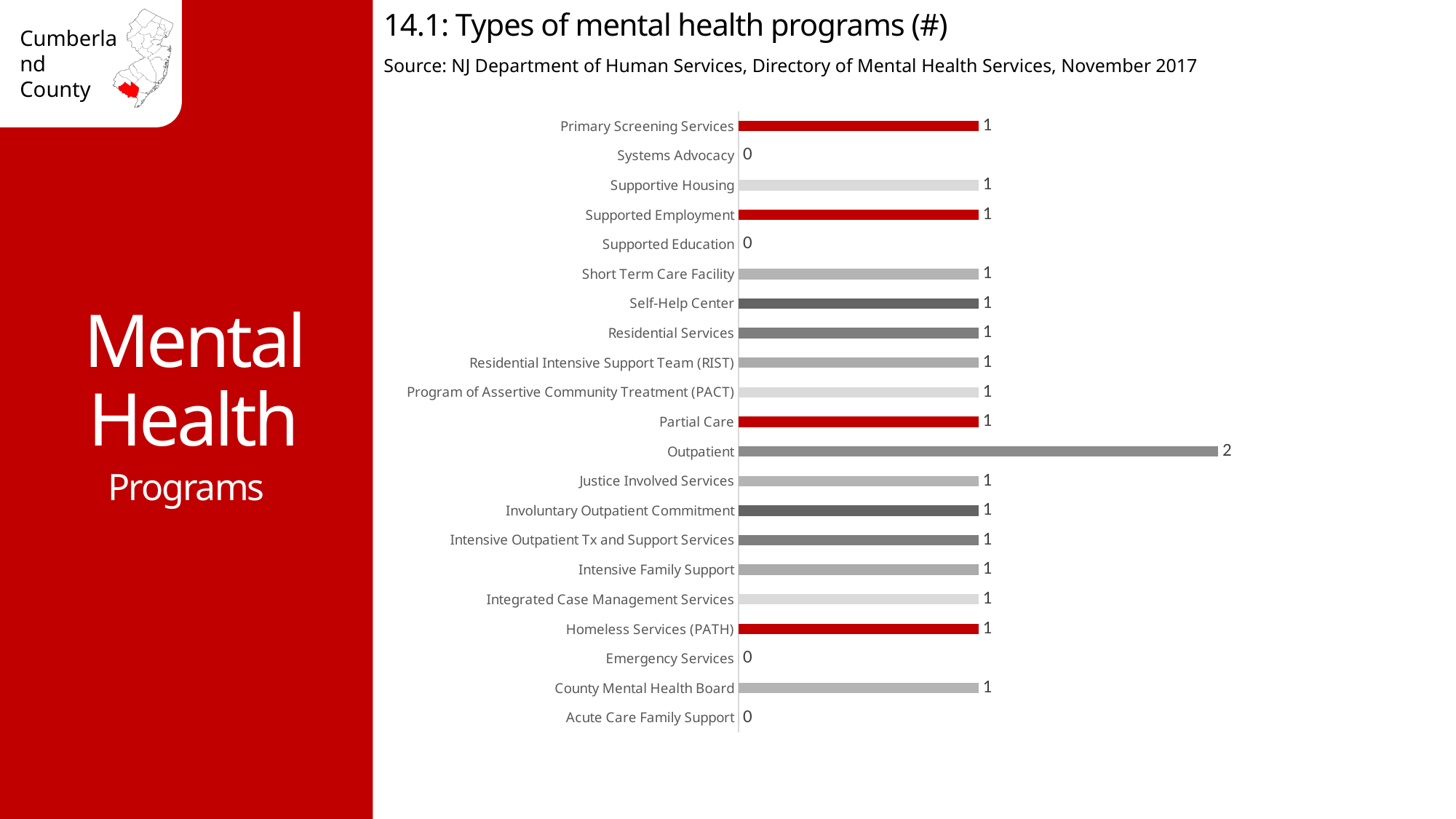
Which is larger, the value for Supported Employment or the value for Supported Education? Supported Employment What is the value for Systems Advocacy? 0 What kind of chart is shown on the slide? Bar chart What source is cited for the chart? NJ Department of Human Services, Directory of Mental Health Services, November 2017 What is the value for Outpatient? 2 How many categories have a value of 0? 4 What is the value for Homeless Services (PATH)? 1 What is the title of the chart? 14.1: Types of mental health programs (#) What is the value for Emergency Services? 0 How many categories are shown on the chart? 21 Which category has the highest value? Outpatient What is the difference between the values for Outpatient and Partial Care? 1